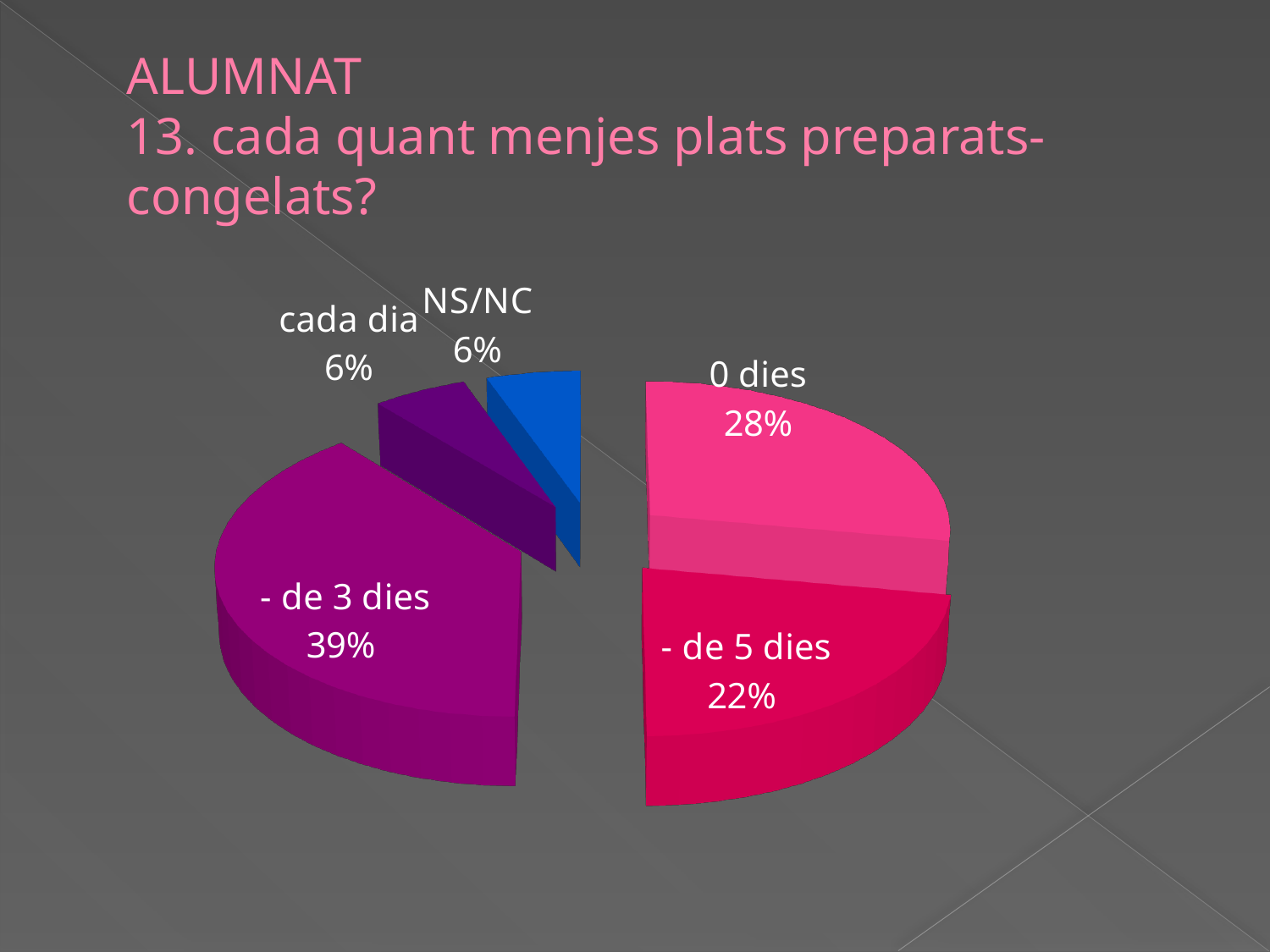
How many slices does the pie chart have? 5 Which category has the largest share of the pie? - de 3 dies What percentage is shown for the '- de 3 dies' slice? 39% What percentage is shown for the '- de 5 dies' slice? 22% What percentage is shown for the 'cada dia' slice? 6% What kind of chart is shown on the slide? pie chart What is the combined share of 'cada dia' and 'NS/NC'? 12% What is the title of the chart on the slide? ALUMNAT 13. cada quant menjes plats preparats-congelats? What percentage is shown for the '0 dies' slice? 28% What percentage is shown for the 'NS/NC' slice? 6% Which is larger, the share for '0 dies' or the share for '- de 5 dies'? 0 dies What is the difference in percentage points between '- de 3 dies' and '0 dies'? 11